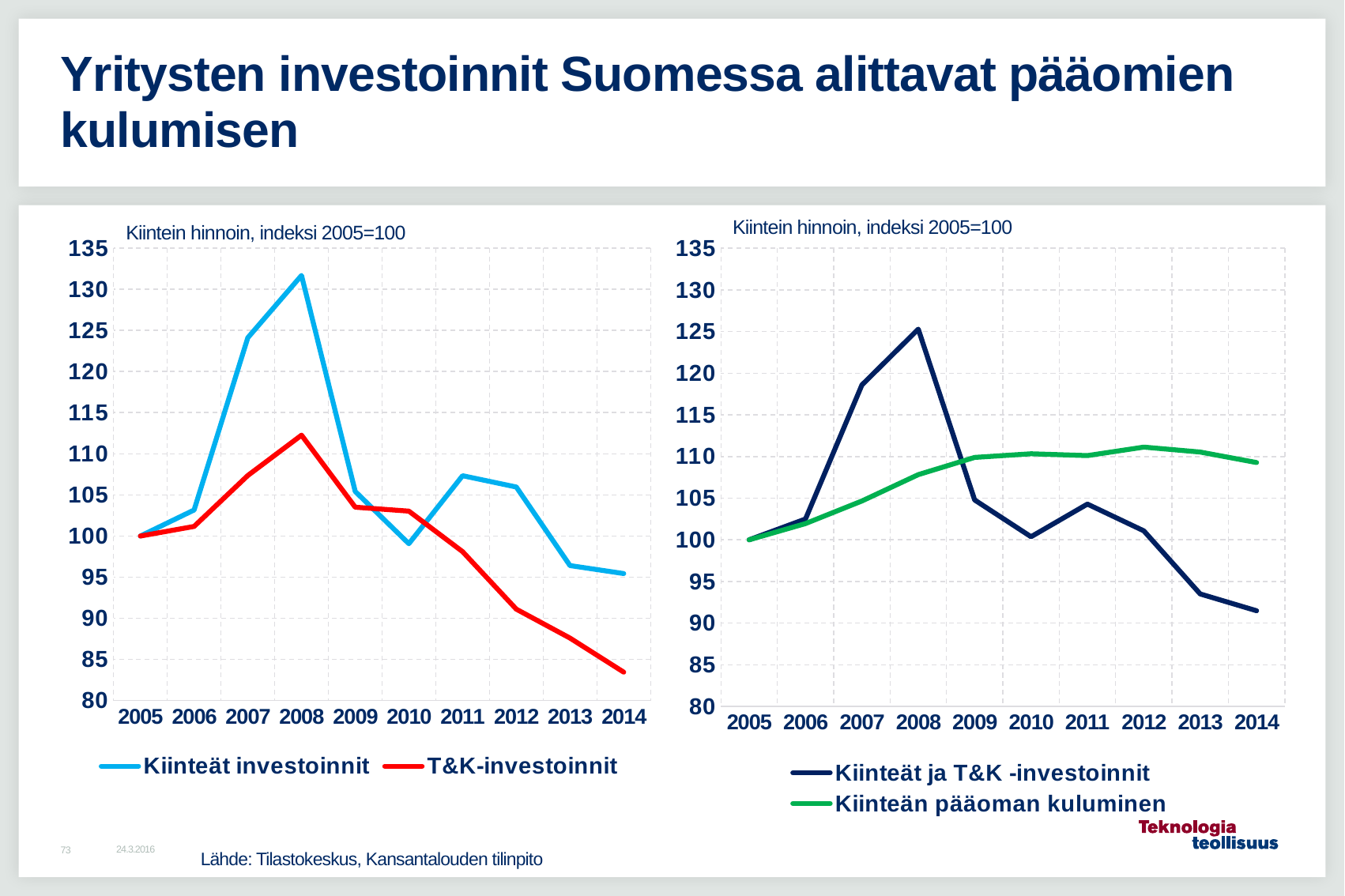
In the right chart, in which year does Kiinteät ja T&K -investoinnit reach its highest value? 2008 In the left chart, is the value for Kiinteät investoinnit in 2008 greater or less than 130? greater In the left chart, in which year is T&K-investoinnit at its lowest? 2014 How many series does the legend of the right chart list? 2 In the left chart, in which year does Kiinteät investoinnit reach its highest value? 2008 In the left chart, what is the value of Kiinteät investoinnit in 2005? 100 In the left chart, does T&K-investoinnit rise or fall from 2008 to 2014? fall In the left chart, is the value for T&K-investoinnit in 2014 greater or less than 85? less How many years are shown on the x axis of the right chart? 10 How many series does the legend of the left chart list? 2 In the right chart, which series has the higher value in 2014, Kiinteät ja T&K -investoinnit or Kiinteän pääoman kuluminen? Kiinteän pääoman kuluminen What kind of chart is the left chart on the slide? line chart